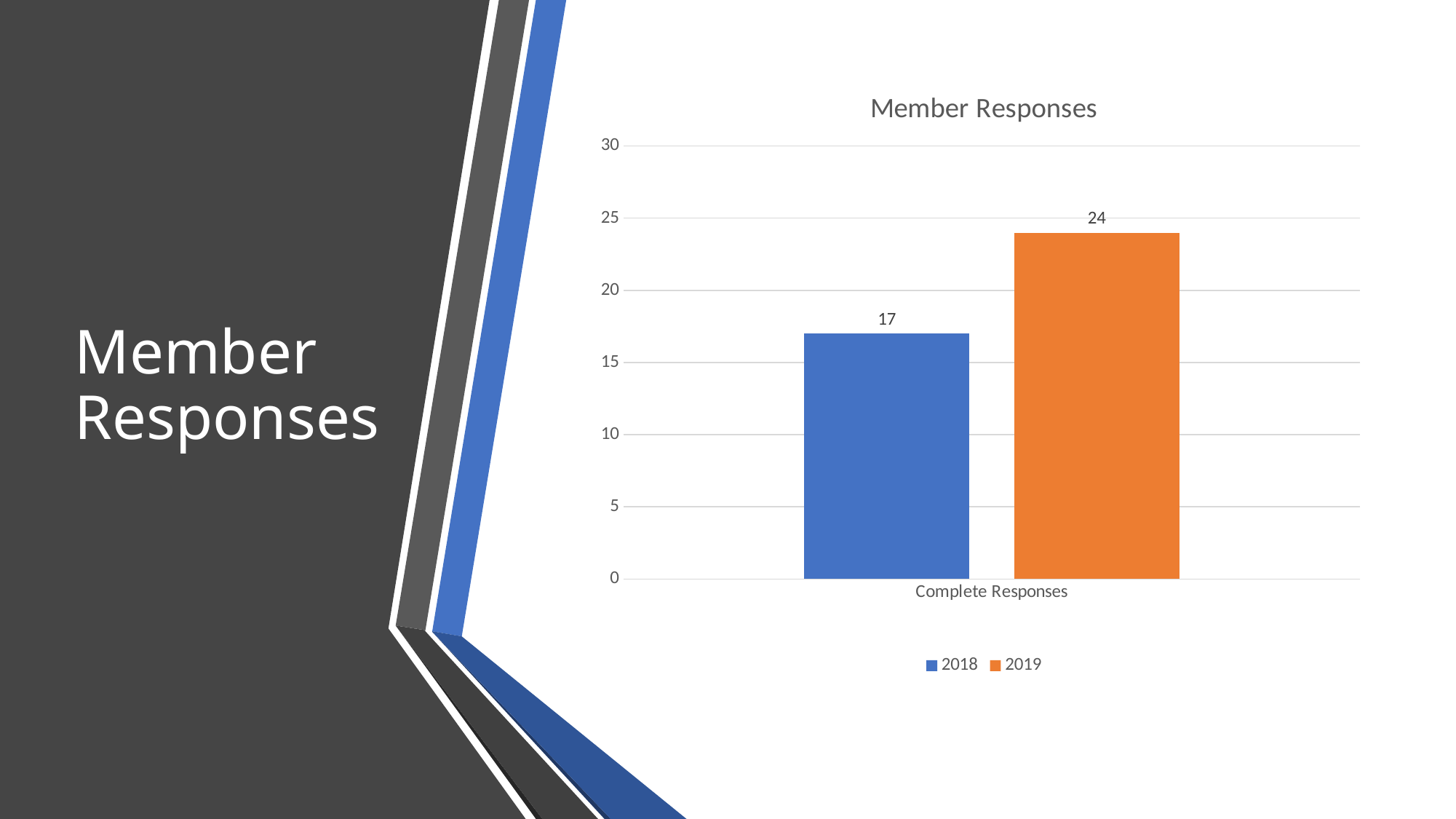
What is the title of the chart? Member Responses Which series has the highest value on the chart? 2019 How many categories are shown on the x axis? 1 Is the value for 2018 greater or less than 20? less What is the value for 2019 in the Complete Responses category? 24 What is the value for 2018 in the Complete Responses category? 17 Is the value for 2019 greater or less than 20? greater How many series does the legend list? 2 Which series has the lowest value on the chart? 2018 What is the difference between the 2019 and 2018 values for Complete Responses? 7 Which series has the higher value for Complete Responses, 2018 or 2019? 2019 What kind of chart is shown on the slide? Bar chart